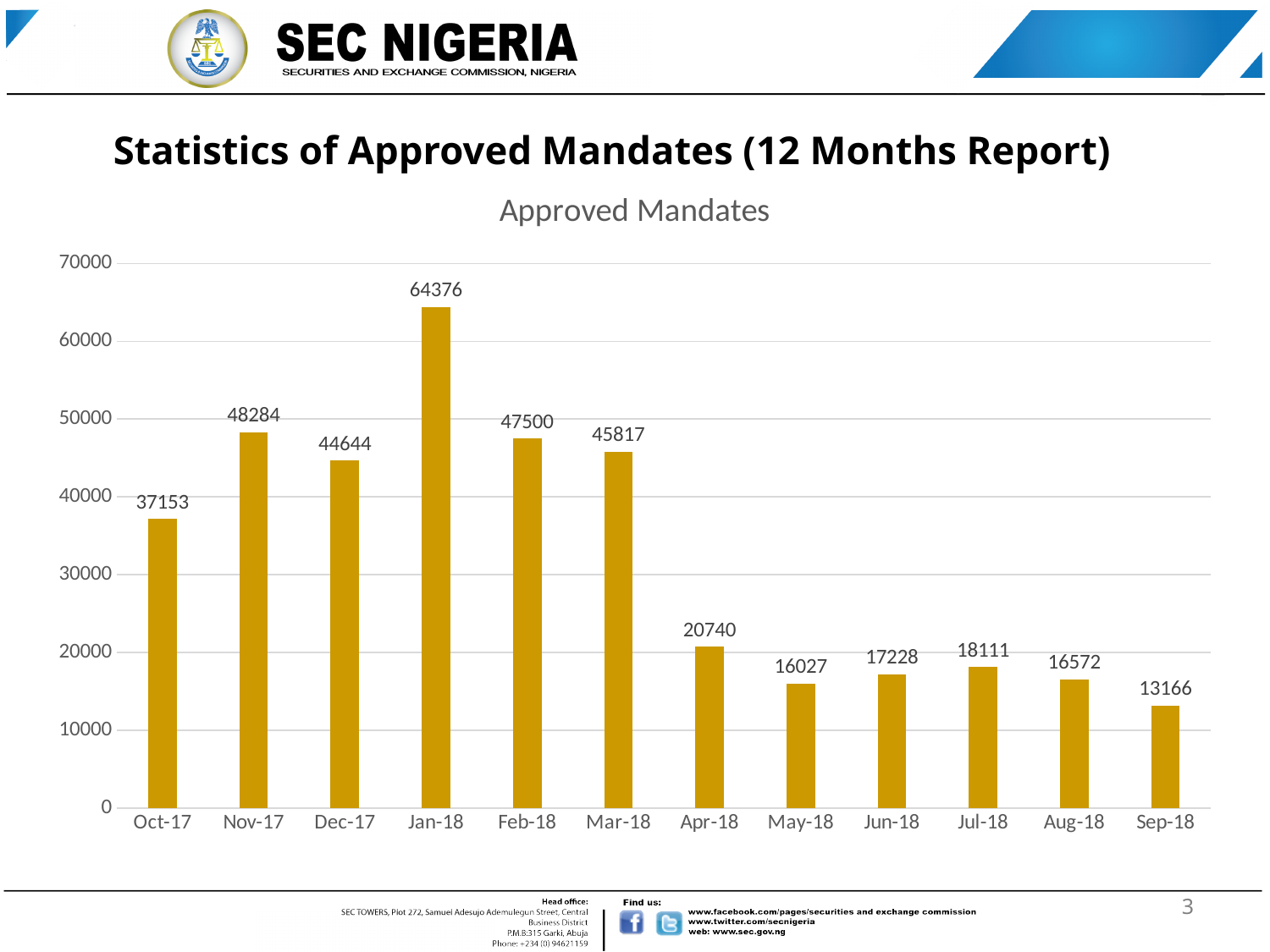
Which month has the highest number of approved mandates? Jan-18 How many months are shown on the x axis of the chart? 12 Which month has the lowest number of approved mandates? Sep-18 What is the difference between the approved mandates for Jan-18 and Sep-18? 51210 Do the approved mandates rise or fall from Mar-18 to Apr-18? Fall What kind of chart is shown on the slide? Bar chart What is the difference between the approved mandates for Nov-17 and Dec-17? 3640 What is the title of the chart? Approved Mandates Which month has more approved mandates, Feb-18 or Mar-18? Feb-18 What is the value of approved mandates for Jan-18? 64376 Is the value for Apr-18 greater or less than 20000? greater What is the value of approved mandates for May-18? 16027